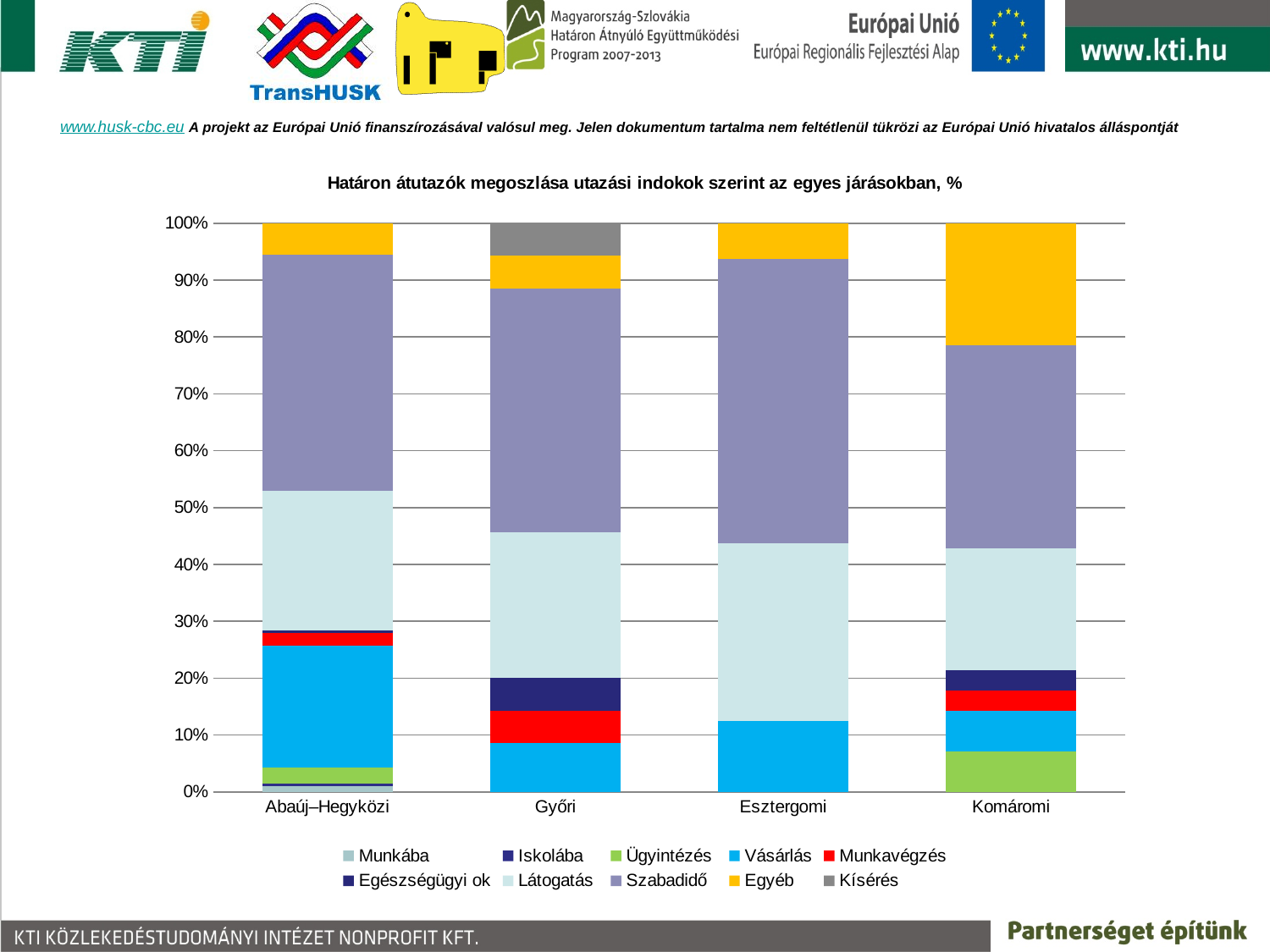
Is the Egyéb share for Komáromi greater or less than 10%? greater What is the total of the Győri stacked bar? 100% Which district has the largest Szabadidő segment? Esztergomi Which district has the largest Egyéb segment? Komáromi How many series does the legend list? 10 What is the title of the chart? Határon átutazók megoszlása utazási indokok szerint az egyes járásokban, % Is the Szabadidő share for Esztergomi greater or less than 40%? greater What kind of chart is shown on the slide? Stacked bar chart Which district is the only one with a Kísérés segment? Győri Which district has the largest Vásárlás segment? Abaúj–Hegyközi How many districts (categories) are shown on the x axis? 4 Is the Vásárlás share for Abaúj–Hegyközi greater or less than 10%? greater